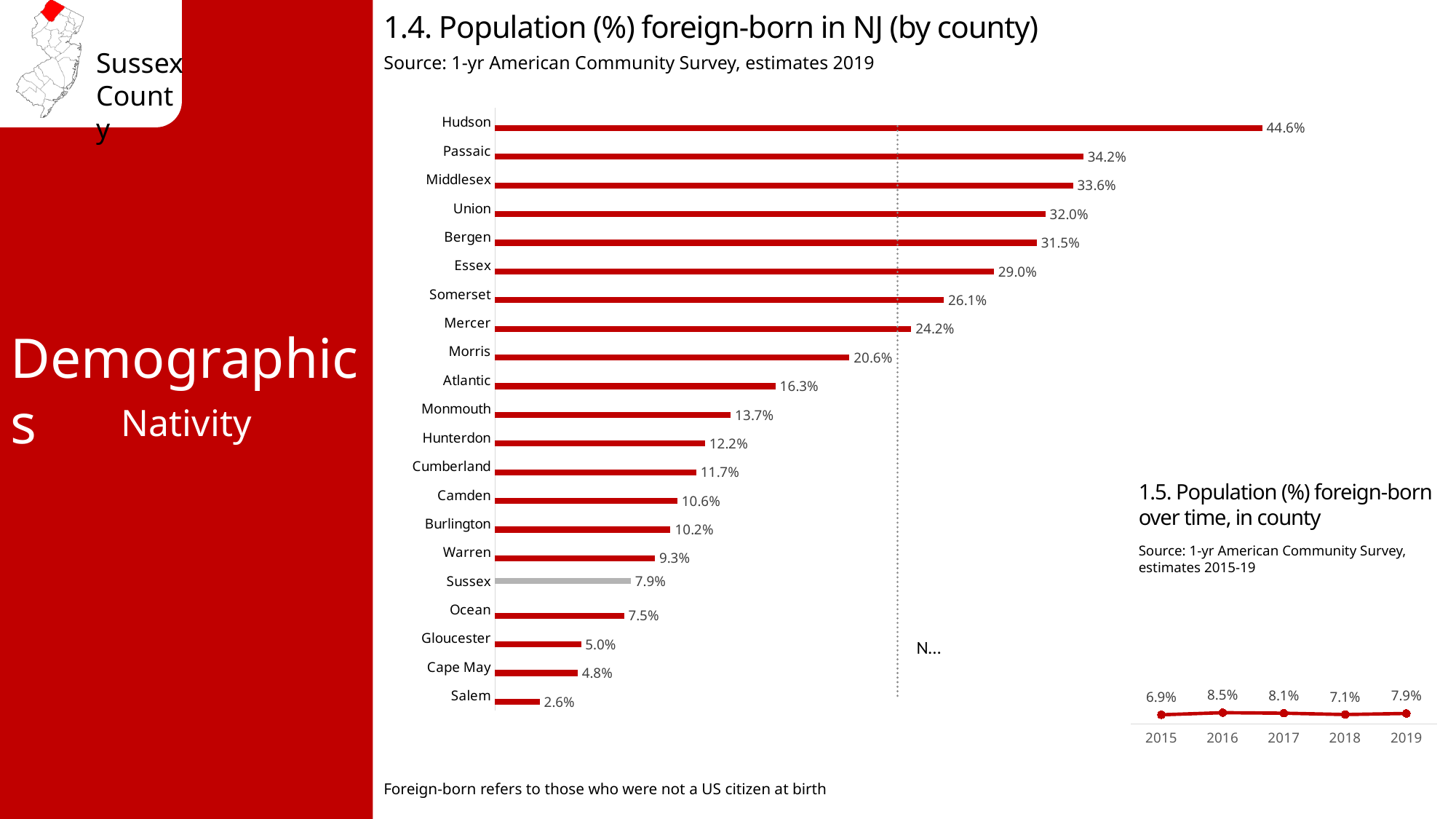
In the chart '1.4. Population (%) foreign-born in NJ (by county)', which is larger, Morris or Atlantic? Morris In the chart '1.4. Population (%) foreign-born in NJ (by county)', how many counties are shown? 21 In the chart '1.4. Population (%) foreign-born in NJ (by county)', what is the value for Sussex? 7.9% In the chart '1.4. Population (%) foreign-born in NJ (by county)', which county has the lowest value? Salem In the chart '1.4. Population (%) foreign-born in NJ (by county)', which county has the highest value? Hudson In the chart '1.5. Population (%) foreign-born over time, in county', which year has the lowest value? 2015 In the chart '1.4. Population (%) foreign-born in NJ (by county)', what is the value for Bergen? 31.5% In the chart '1.5. Population (%) foreign-born over time, in county', how many years are plotted? 5 What kind of chart is '1.4. Population (%) foreign-born in NJ (by county)'? Bar chart In the chart '1.4. Population (%) foreign-born in NJ (by county)', which county's bar is coloured grey instead of red? Sussex In the chart '1.4. Population (%) foreign-born in NJ (by county)', what is the difference between Hudson and Passaic? 10.4% In the chart '1.5. Population (%) foreign-born over time, in county', what is the value for 2016? 8.5%